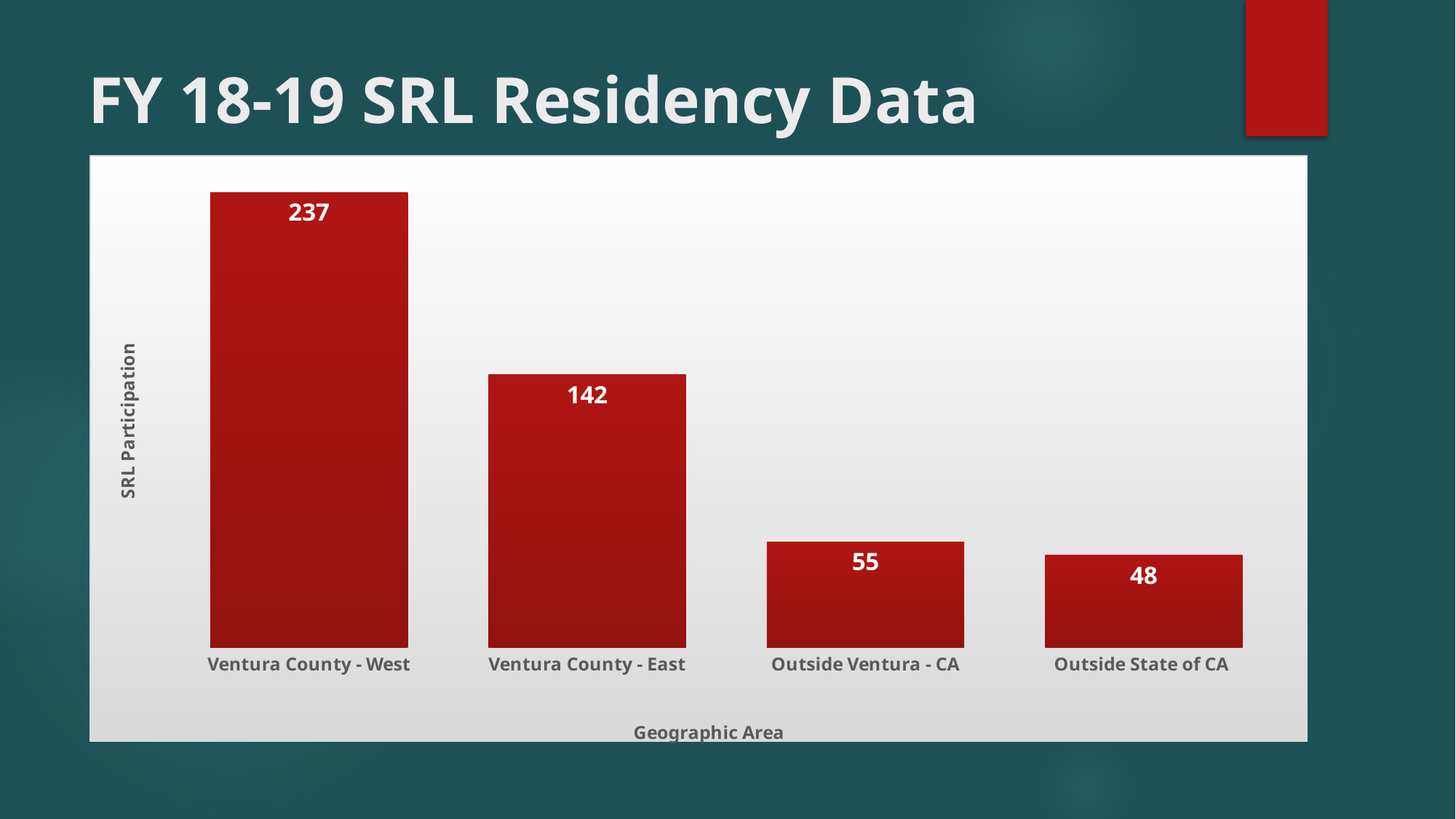
Which has a larger SRL Participation value, Ventura County - East or Outside Ventura - CA? Ventura County - East What is the label of the x axis of the chart? Geographic Area What is the difference in SRL Participation between Ventura County - West and Ventura County - East? 95 What is the SRL Participation value for Outside Ventura - CA? 55 Which geographic area has the lowest SRL Participation? Outside State of CA What is the SRL Participation value for Outside State of CA? 48 What is the SRL Participation value for Ventura County - West? 237 What kind of chart is shown on the slide? Bar chart Which geographic area has the highest SRL Participation? Ventura County - West How many geographic areas are shown in the chart? 4 What is the difference in SRL Participation between Outside Ventura - CA and Outside State of CA? 7 What is the SRL Participation value for Ventura County - East? 142